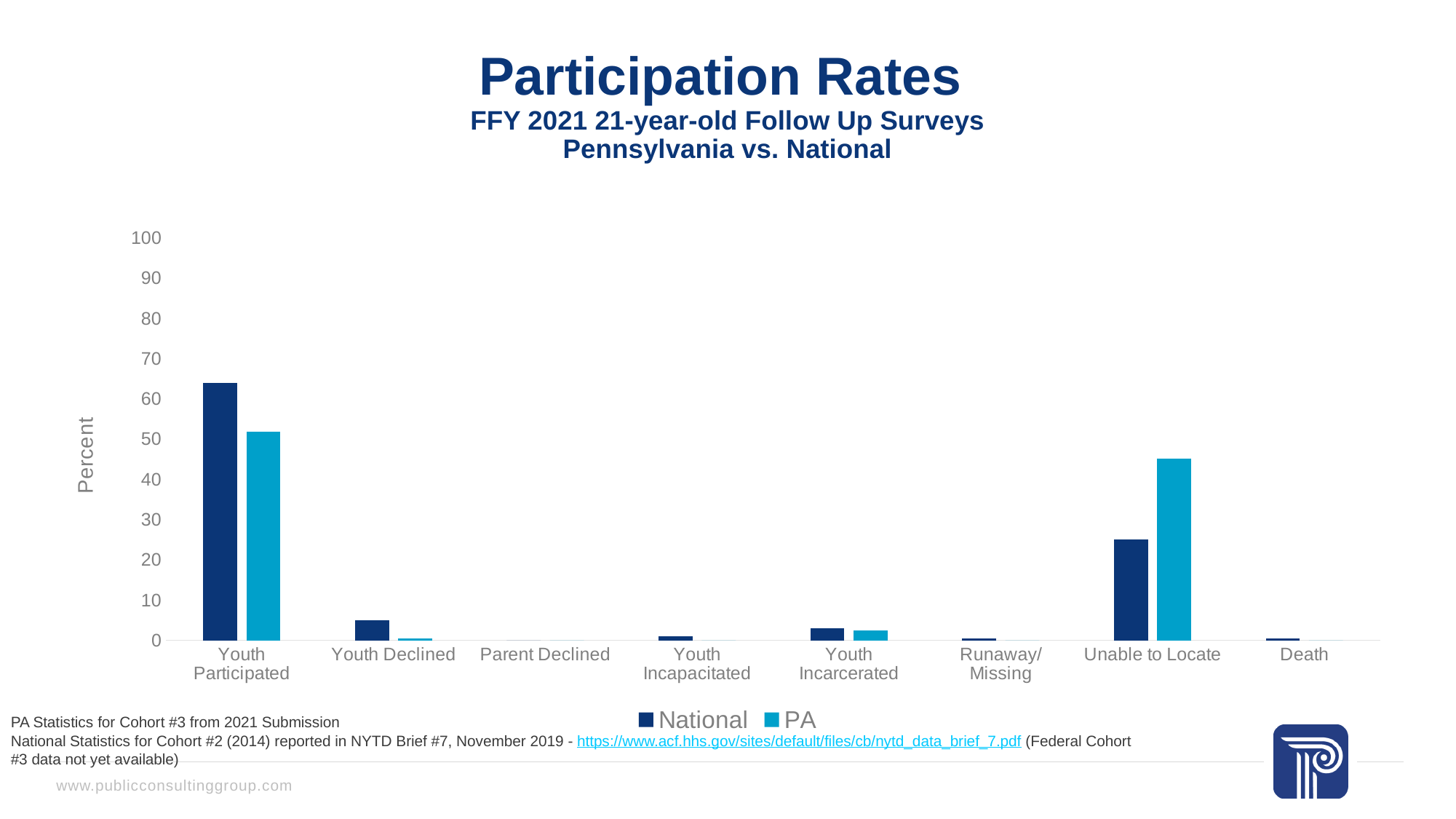
Is the PA value for Unable to Locate greater or less than 40? greater How many series does the legend list? 2 How many categories are shown along the x axis? 8 Is the National value for Youth Participated greater or less than 60? greater What is the label on the vertical axis of the chart? Percent For Youth Participated, which is larger, the National value or the PA value? National Is the PA value for Youth Participated greater or less than 60? less For Unable to Locate, which is larger, the National value or the PA value? PA Which category has the highest National value? Youth Participated Which category has the highest PA value? Youth Participated What kind of chart is shown on the slide? Bar chart For Youth Declined, which is larger, the National value or the PA value? National